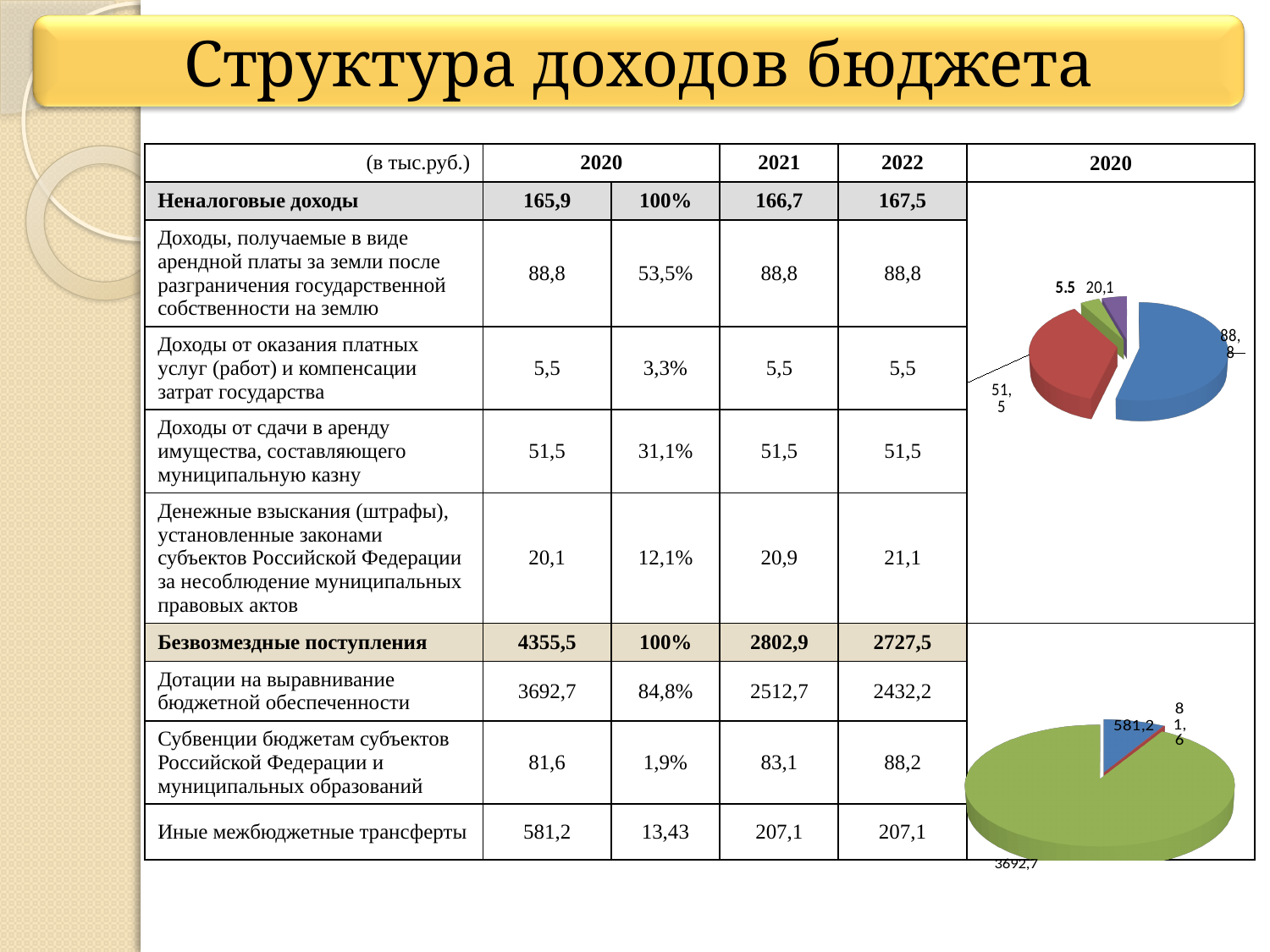
What colour is the largest slice in the lower pie chart? green What is the total of all slice values in the upper pie chart? 165,9 What kind of chart is the upper chart on the right side of the slide? pie chart What is the total of all slice values in the lower pie chart? 4355,5 In the upper pie chart, what is the value of the smallest slice? 5.5 In the lower pie chart, what is the value of the largest slice? 3692,7 In the upper pie chart, what is the difference between the slice labelled 88,8 and the slice labelled 51,5? 37,3 In the upper pie chart, which slice is larger: the one labelled 51,5 or the one labelled 20,1? 51,5 How many slices does the lower pie chart have? 3 In the upper pie chart, what is the value of the largest slice? 88,8 In the upper pie chart, what share of the total does the slice labelled 88,8 represent? 53,5% How many slices does the upper pie chart have? 4